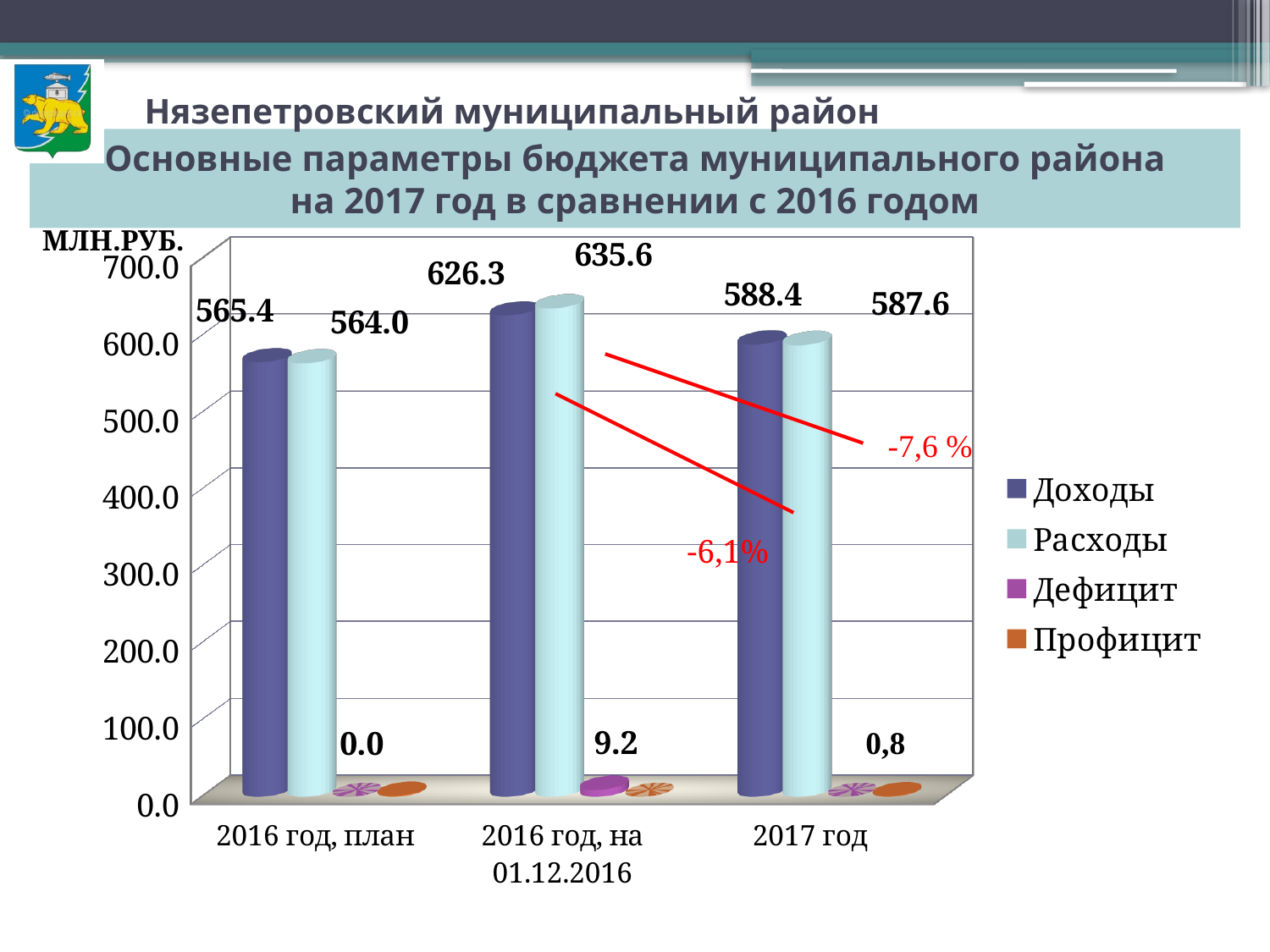
What is the value of Доходы for 2017 год? 588.4 How many categories are shown on the x axis? 3 What unit is indicated at the top of the vertical axis? МЛН.РУБ. What is the difference between Доходы for 2016 год, на 01.12.2016 and Доходы for 2017 год? 37.9 What is the value of Расходы for 2016 год, на 01.12.2016? 635.6 Which category has the lowest value for Расходы? 2016 год, план What is the value of Расходы for 2017 год? 587.6 How many series does the legend list? 4 Which category has the highest value for Доходы? 2016 год, на 01.12.2016 What type of chart is shown on the slide? bar chart What is the value of Доходы for 2016 год, план? 565.4 Is the value of Расходы for 2016 год, план greater or less than 600.0? less